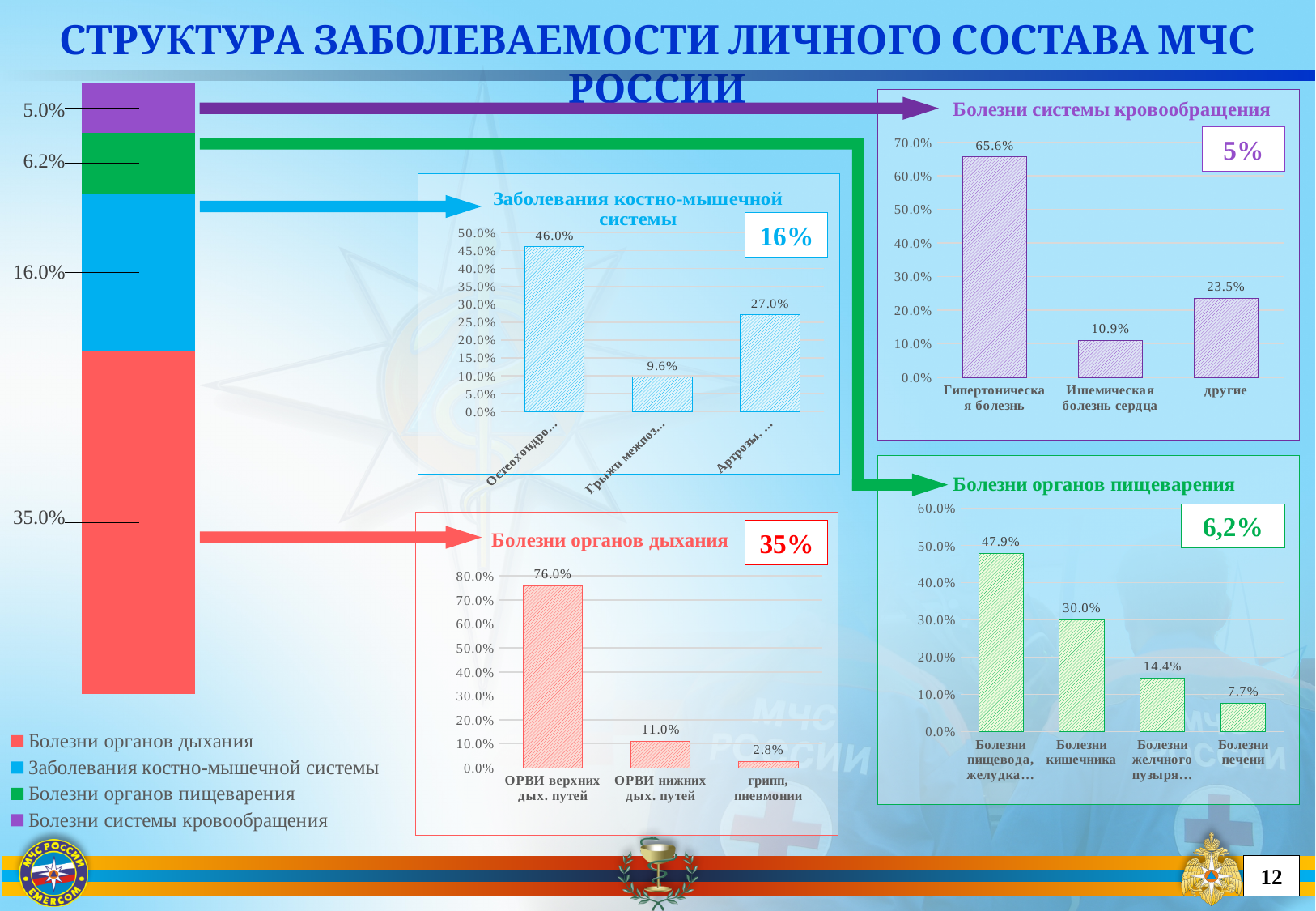
In the chart titled 'Болезни системы кровообращения', which category has the highest value? Гипертоническая болезнь What is the highest value shown in the chart titled 'Заболевания костно-мышечной системы'? 46.0% In the chart titled 'Болезни органов пищеварения', which is larger: 'Болезни кишечника' or 'Болезни печени'? Болезни кишечника What kind of chart is the chart titled 'Болезни органов дыхания'? Bar chart In the chart titled 'Болезни системы кровообращения', what is the value for 'Ишемическая болезнь сердца'? 10.9% In the chart titled 'Болезни органов дыхания', what is the difference between 'ОРВИ нижних дых. путей' and 'грипп, пневмонии'? 8.2% How many categories are shown in the chart titled 'Болезни органов пищеварения'? 4 How many categories are shown in the chart titled 'Заболевания костно-мышечной системы'? 3 In the chart titled 'Болезни органов дыхания', what is the value for 'ОРВИ верхних дых. путей'? 76.0% How many entries does the legend below the stacked bar on the left of the slide list? 4 In the stacked bar on the left of the slide, what is the value of the segment for 'Болезни органов пищеварения'? 6.2% In the chart titled 'Болезни органов пищеварения', which category has the lowest value? Болезни печени